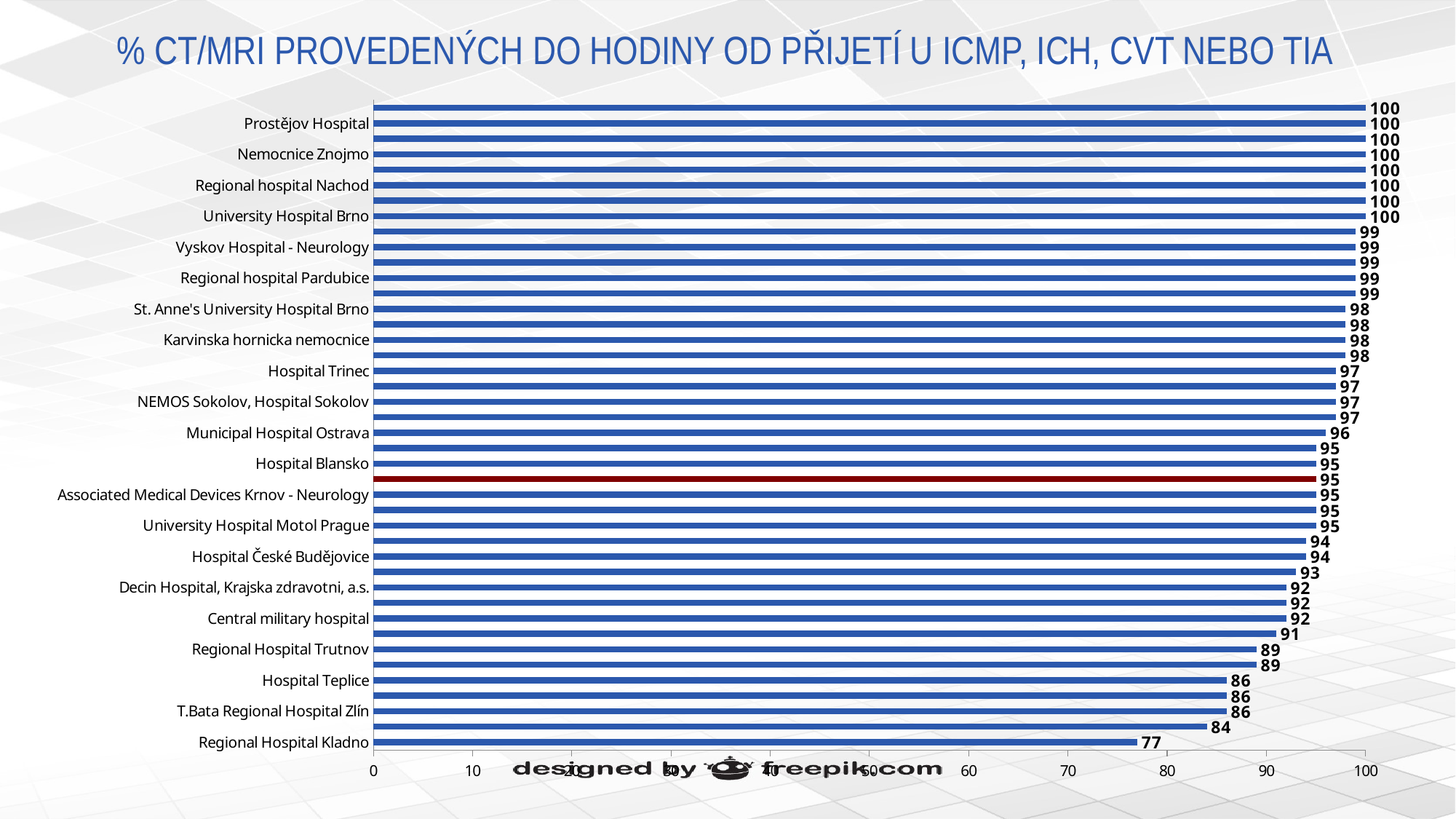
Is the value for Regional Hospital Kladno greater or less than 80? less What is the value of the bar highlighted in dark red? 95 What type of chart is shown on the slide? bar chart Which has a higher value, Hospital České Budějovice or Central military hospital? Hospital České Budějovice What is the value for Hospital Teplice? 86 What is the value for Regional Hospital Trutnov? 89 Which labelled hospital has the lowest value? Regional Hospital Kladno What is the title of the chart? % CT/MRI PROVEDENÝCH DO HODINY OD PŘIJETÍ U ICMP, ICH, CVT NEBO TIA What is the value for Municipal Hospital Ostrava? 96 What is the difference between the values for University Hospital Brno and Regional Hospital Kladno? 23 What is the value for Regional Hospital Kladno? 77 What is the value for Prostějov Hospital? 100